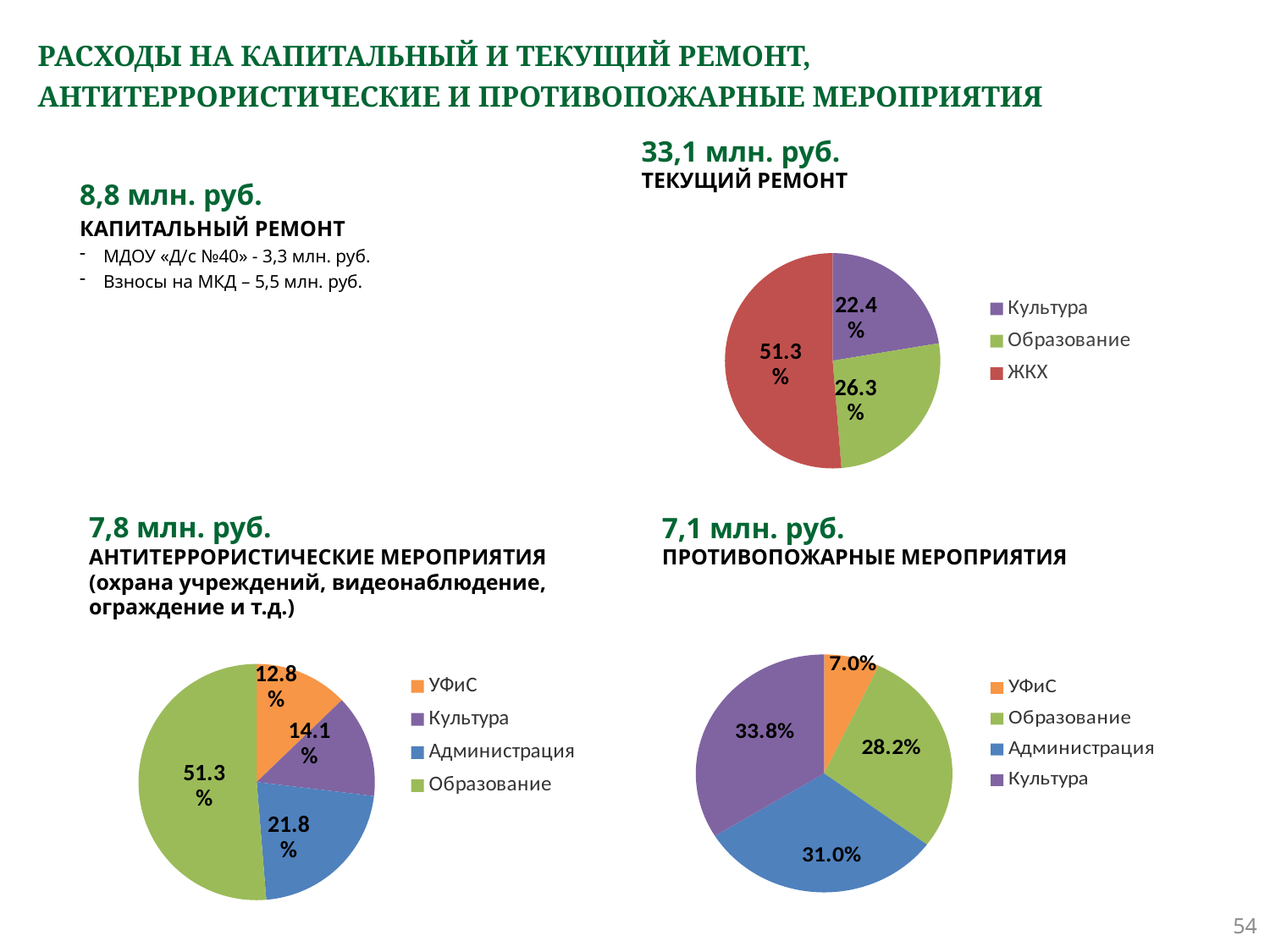
In the "АНТИТЕРРОРИСТИЧЕСКИЕ МЕРОПРИЯТИЯ" pie chart, how many slices are there? 4 In the "АНТИТЕРРОРИСТИЧЕСКИЕ МЕРОПРИЯТИЯ" pie chart, what share does Администрация have? 21.8% In the "ПРОТИВОПОЖАРНЫЕ МЕРОПРИЯТИЯ" pie chart, what share does Культура have? 33.8% In the "ПРОТИВОПОЖАРНЫЕ МЕРОПРИЯТИЯ" pie chart, which category has the smallest share? УФиС In the "ТЕКУЩИЙ РЕМОНТ" pie chart, how many categories does the legend list? 3 In the "ПРОТИВОПОЖАРНЫЕ МЕРОПРИЯТИЯ" pie chart, which is larger: Администрация or Образование? Администрация What type of chart is used for "ТЕКУЩИЙ РЕМОНТ"? Pie chart In the "ТЕКУЩИЙ РЕМОНТ" pie chart, what share does ЖКХ have? 51.3% In the "АНТИТЕРРОРИСТИЧЕСКИЕ МЕРОПРИЯТИЯ" pie chart, which category has the largest share? Образование In the "АНТИТЕРРОРИСТИЧЕСКИЕ МЕРОПРИЯТИЯ" pie chart, what is the difference between the shares of Администрация and УФиС? 9.0% In the "ТЕКУЩИЙ РЕМОНТ" pie chart, which category has the smallest share? Культура In the "ТЕКУЩИЙ РЕМОНТ" pie chart, what share does Культура have? 22.4%